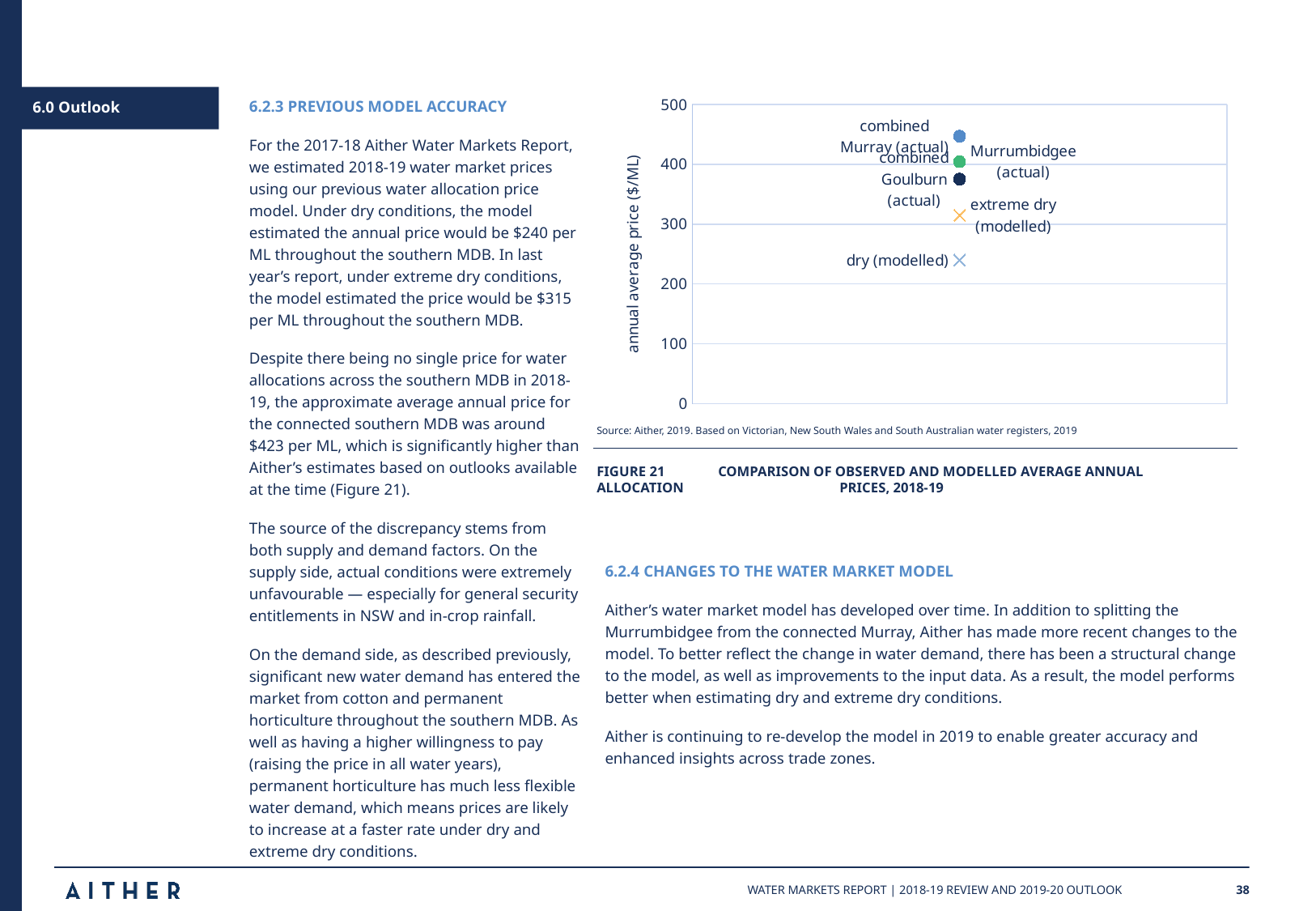
What is the highest tick value shown on the vertical axis? 500 Which is larger, the value for combined Murray (actual) or the value for dry (modelled)? combined Murray (actual) What is the label on the vertical axis of the chart? annual average price ($/ML) Is the value for combined Murray (actual) greater or less than 400? greater Is the value for dry (modelled) greater or less than 200? greater What kind of chart is shown on the slide? scatter chart Is the value for combined Goulburn (actual) greater or less than 400? less Which data point has the highest annual average price? combined Murray (actual) Which data point has the lowest annual average price? dry (modelled) Which is larger, the value for Murrumbidgee (actual) or the value for extreme dry (modelled)? Murrumbidgee (actual) How many data points are plotted on the chart? 5